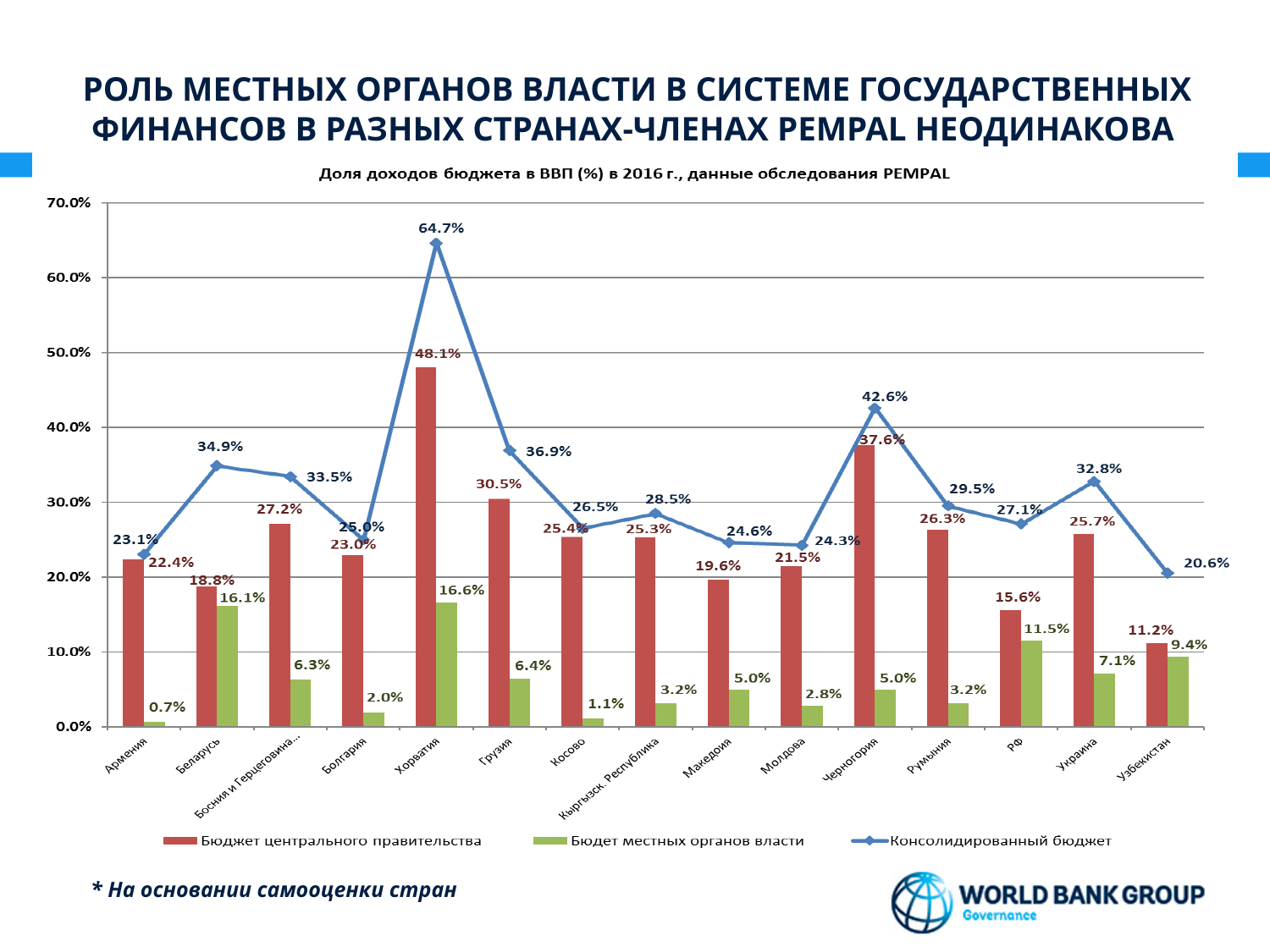
Which country has the highest consolidated budget (Консолидированный бюджет) value? Хорватия What is the central government budget (Бюджет центрального правительства) value for Хорватия? 48.1% How many countries are shown on the x axis of the chart? 15 What is the title of the chart? Доля доходов бюджета в ВВП (%) в 2016 г., данные обследования PEMPAL How many series does the legend list? 3 What is the consolidated budget (Консолидированный бюджет) value for Черногория? 42.6% What is the difference between the consolidated budget value for Хорватия and for Узбекистан? 44.1% Which country has the lowest central government budget (Бюджет центрального правительства) value? Узбекистан Which is larger: the local government budget value for РФ or for Украина? РФ What kind of chart is shown on the slide? Combined bar and line chart What is the local government budget (Бюдет местных органов власти) value for Беларусь? 16.1% Which country has the lowest local government budget (Бюдет местных органов власти) value? Армения